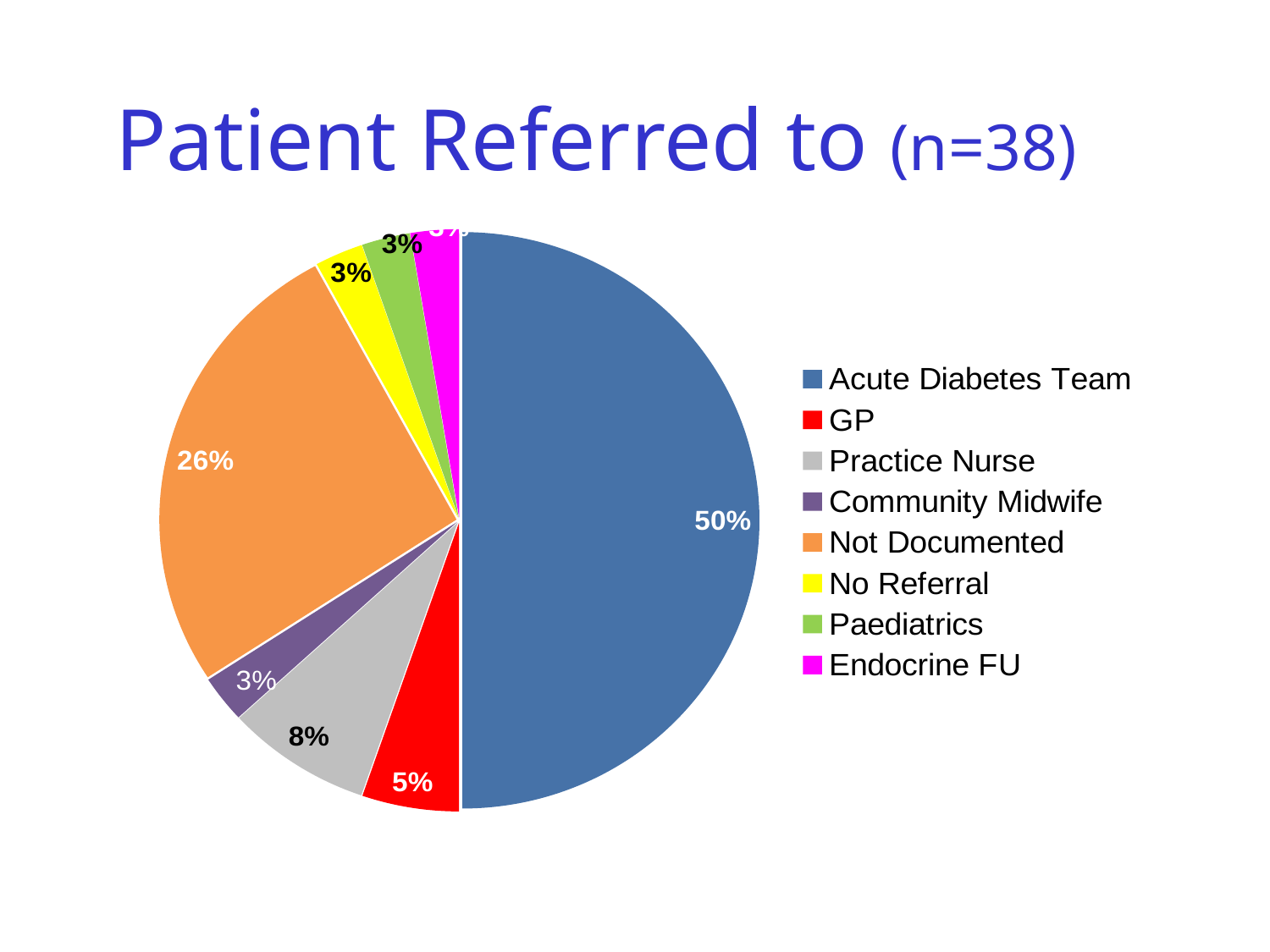
What percentage of referrals were Not Documented? 26% Which is larger, the share for Practice Nurse or the share for GP? Practice Nurse What is the sample size shown in the chart title? n=38 What is the difference in percentage points between the Acute Diabetes Team share and the Not Documented share? 24 Which colour represents No Referral in the legend? yellow How many categories does the legend list? 8 What percentage of patients were referred to the Acute Diabetes Team? 50% What percentage of patients were referred to the Community Midwife? 3% Which category has the largest share of the pie? Acute Diabetes Team What percentage of patients were referred to the Practice Nurse? 8% What kind of chart is shown on the slide? pie chart What percentage of patients were referred to the GP? 5%